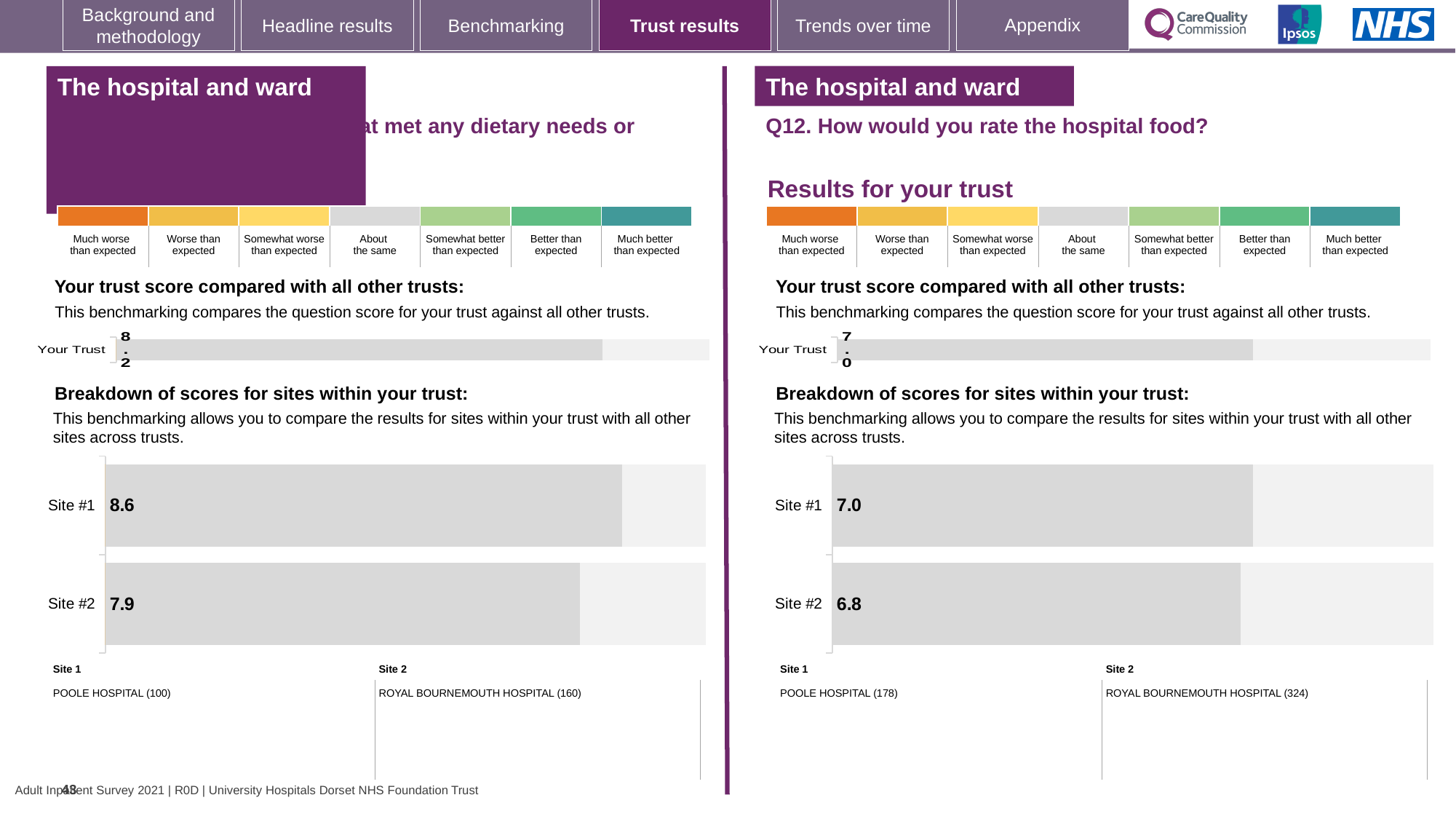
On the left half of the slide, what is the score for Site #1 in the breakdown of scores for sites within your trust? 8.6 On the right half of the slide (Q12), what is the score for Site #2 in the breakdown of scores for sites within your trust? 6.8 What kind of chart is used for the breakdown of scores for sites within your trust on the right half of the slide (Q12)? Bar chart On the right half of the slide (Q12. How would you rate the hospital food?), what is the score for Site #1 in the breakdown of scores for sites within your trust? 7.0 On the right half of the slide (Q12), what is the difference between the Site #1 and Site #2 scores in the site breakdown chart? 0.2 On the left half of the slide, which site has the lower score in the site breakdown chart? Site #2 On the right half of the slide (Q12), what is the 'Your Trust' score shown in the trust score comparison chart? 7.0 On the left half of the slide, what is the difference between the Site #1 and Site #2 scores in the site breakdown chart? 0.7 On the right half of the slide (Q12), which site has the higher score in the site breakdown chart? Site #1 On the left half of the slide, what is the 'Your Trust' score shown in the trust score comparison chart? 8.2 On the left half of the slide, what is the score for Site #2 in the breakdown of scores for sites within your trust? 7.9 How many sites are shown in the site breakdown chart on the right half of the slide (Q12)? 2